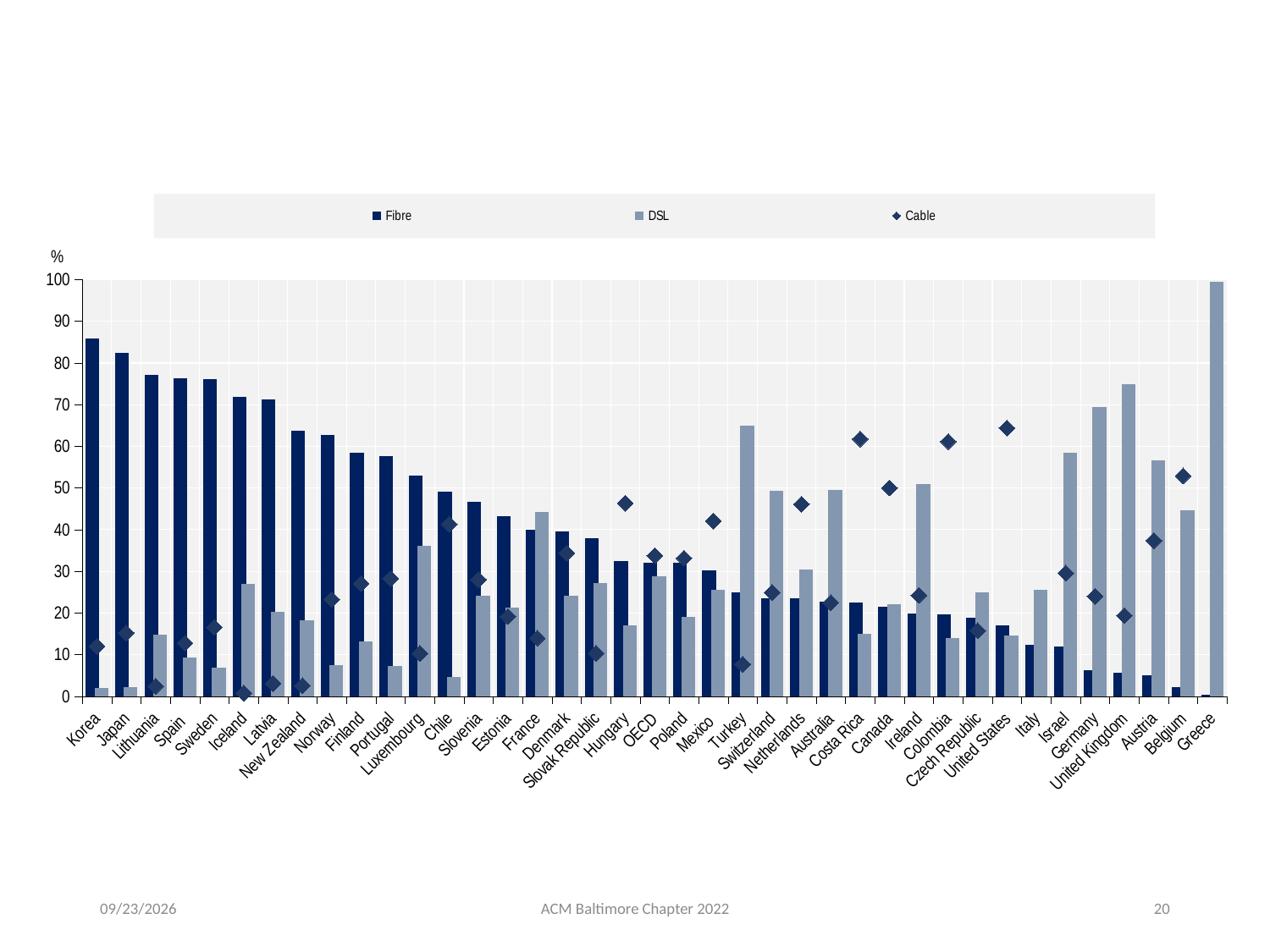
Is the Fibre value for Korea greater or less than 80? greater Which country has the highest DSL value? Greece What are the three series named in the legend? Fibre, DSL, Cable Is the DSL value for Turkey greater or less than 60? greater Do the Fibre values rise or fall moving from left to right along the x axis? fall Which country has the lowest Fibre value? Greece What kind of chart is used to plot the Fibre and DSL series? bar chart Is the Cable value for Hungary greater or less than 40? greater Which country has the highest Fibre value? Korea Which is larger for Turkey, the Fibre value or the DSL value? DSL How many series does the legend list? 3